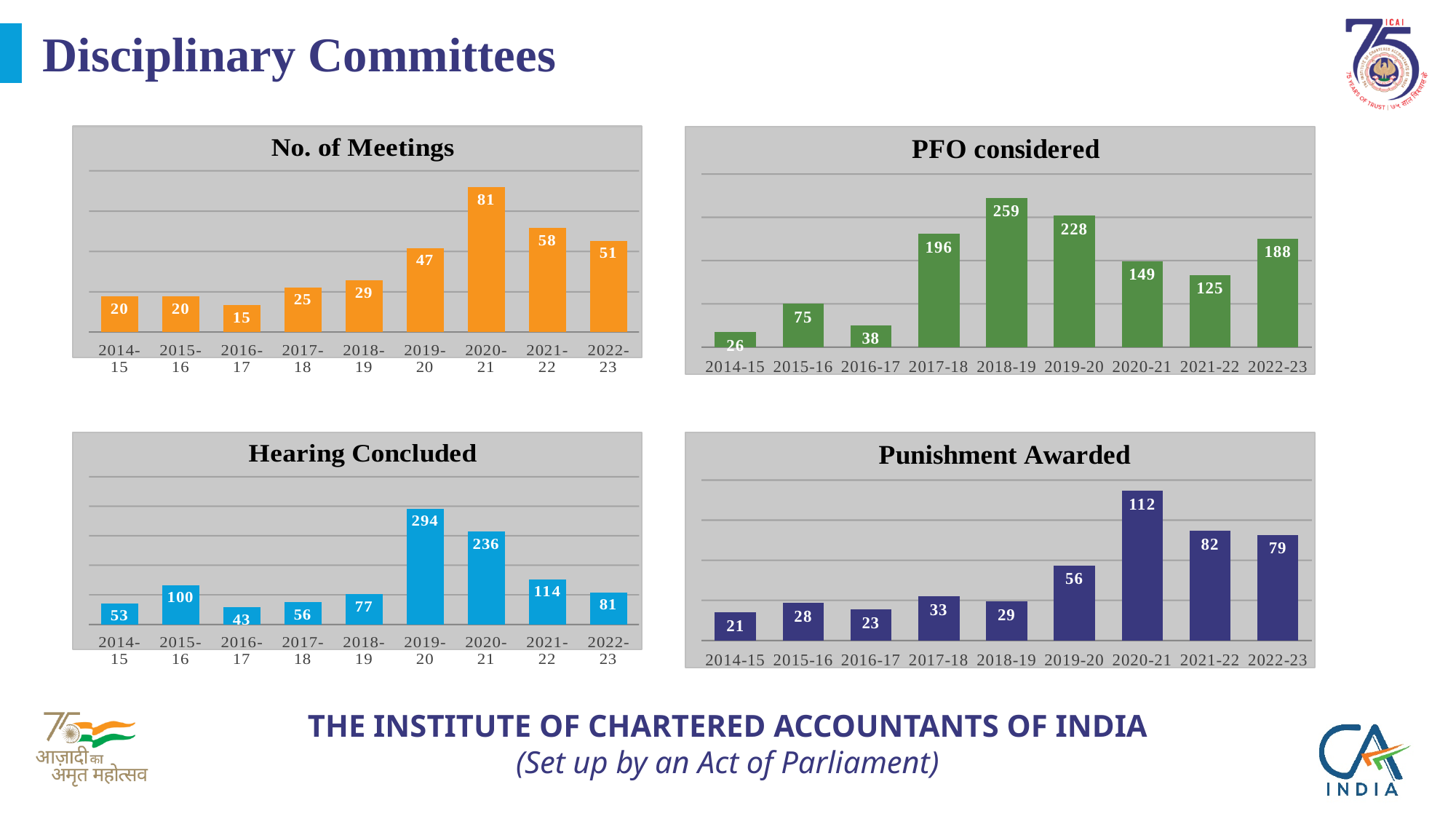
In the 'Punishment Awarded' chart, what is the difference between the values for 2020-21 and 2022-23? 33 How many years are shown on the x axis of the 'Punishment Awarded' chart? 9 In the 'Hearing Concluded' chart, which is larger: the value for 2015-16 or the value for 2018-19? 2015-16 In the 'PFO considered' chart, what is the value for 2014-15? 26 What colour are the bars in the 'Hearing Concluded' chart? Blue In the 'No. of Meetings' chart, which year has the lowest value? 2016-17 In the 'No. of Meetings' chart, what is the value for 2020-21? 81 In the 'Punishment Awarded' chart, what is the value for 2019-20? 56 In the 'PFO considered' chart, which year has the highest value? 2018-19 What kind of chart is the 'No. of Meetings' chart? Bar chart In the 'PFO considered' chart, what is the difference between the values for 2018-19 and 2019-20? 31 In the 'Hearing Concluded' chart, which year has the lowest value? 2016-17